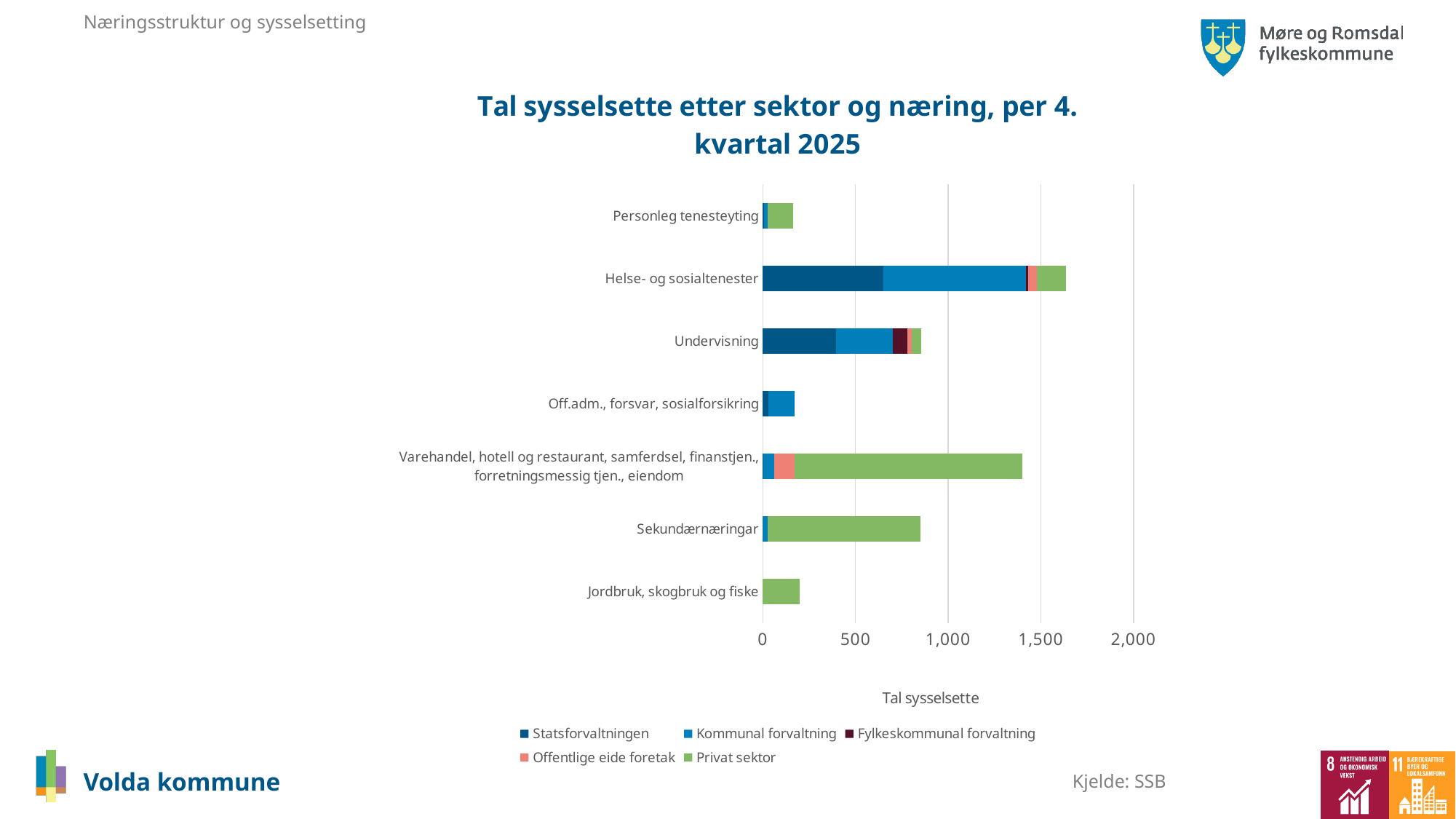
What kind of chart is shown on the slide? bar chart Is the total value for Helse- og sosialtenester greater or less than 1,500? greater Which has a larger total: Sekundærnæringar or Jordbruk, skogbruk og fiske? Sekundærnæringar Is the total value for Jordbruk, skogbruk og fiske greater or less than 500? less How many series does the legend list? 5 Which category has the highest total number of sysselsette? Helse- og sosialtenester Is the total value for Varehandel, hotell og restaurant, samferdsel, finanstjen., forretningsmessig tjen., eiendom greater or less than 1,500? less What is the label on the horizontal axis of the chart? Tal sysselsette Which has a larger total: Helse- og sosialtenester or Varehandel, hotell og restaurant, samferdsel, finanstjen., forretningsmessig tjen., eiendom? Helse- og sosialtenester How many categories (næringar) are plotted on the chart? 7